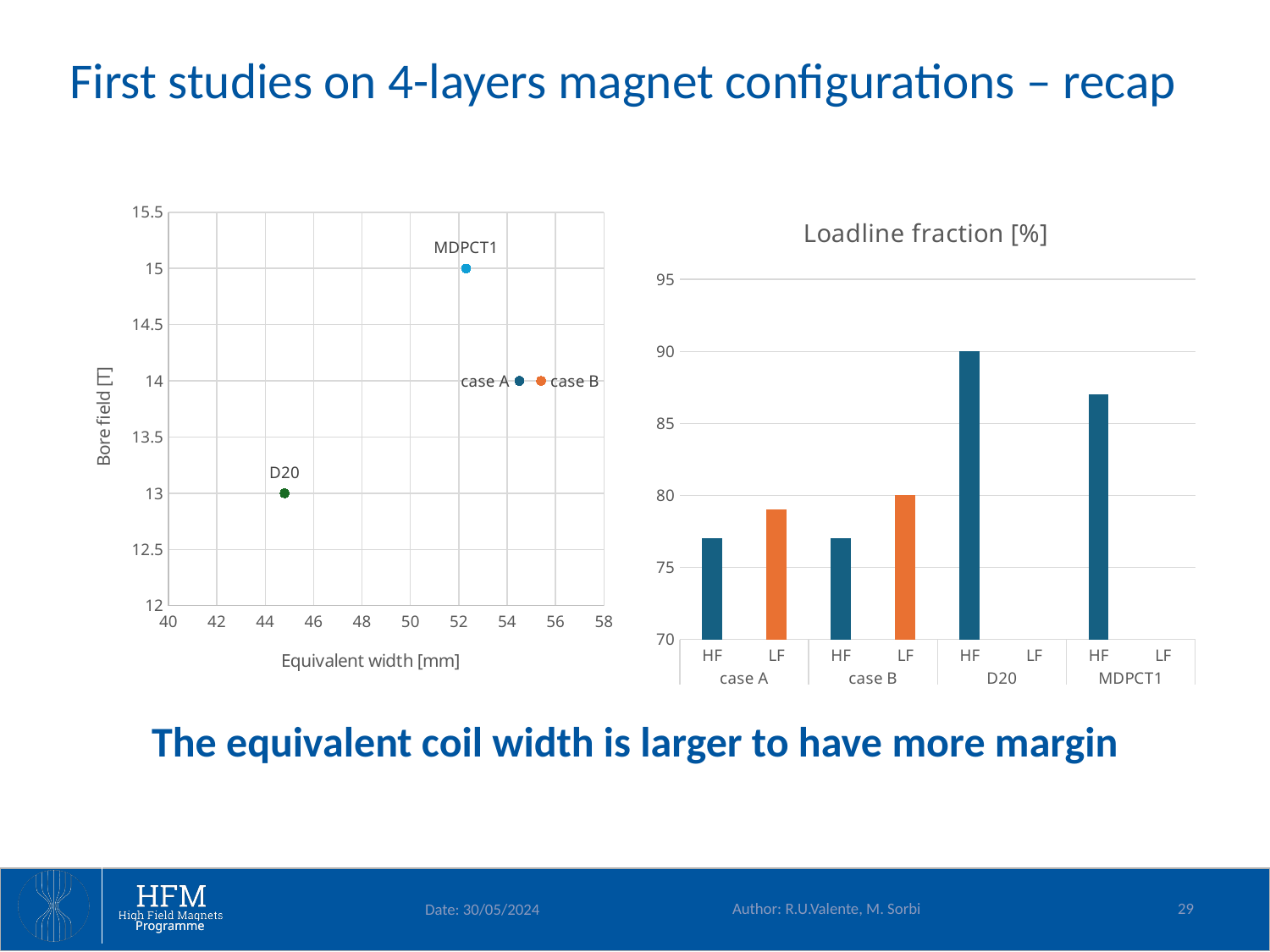
In the 'Loadline fraction [%]' chart, what is the value of the HF bar for D20? 90 In the left chart (Bore field vs Equivalent width), is the equivalent width for D20 greater or less than 46? less What kind of chart is the chart on the left showing Bore field against Equivalent width? scatter chart In the 'Loadline fraction [%]' chart, which bar is the highest? D20 HF In the left chart (Bore field vs Equivalent width), which point has the highest bore field? MDPCT1 In the 'Loadline fraction [%]' chart, which is larger: the HF value for D20 or the HF value for MDPCT1? D20 HF In the left chart (Bore field vs Equivalent width), which point has the lowest bore field? D20 What kind of chart is the chart on the right titled 'Loadline fraction [%]'? bar chart In the 'Loadline fraction [%]' chart, how many magnet groups are shown on the x axis? 4 In the left chart (Bore field vs Equivalent width), what is the bore field for D20? 13 In the left chart (Bore field vs Equivalent width), what is the bore field for MDPCT1? 15 In the 'Loadline fraction [%]' chart, is the HF value for case A greater or less than 80? less